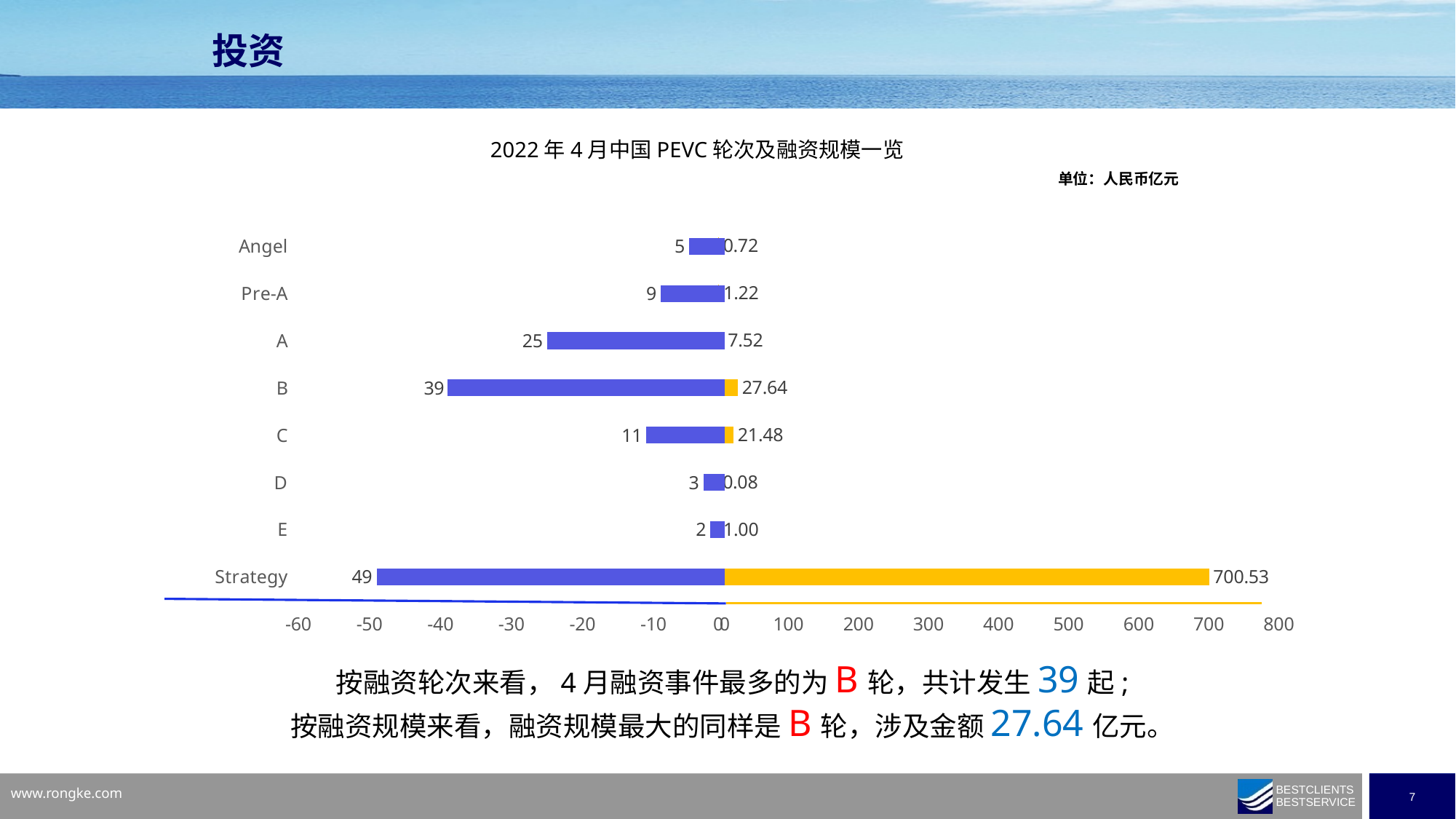
What is the difference in the number of financing events between the Strategy round and the B round? 10 Which round has the fewest financing events? E Which round has the smallest financing amount? D What is the title of the chart? 2022 年 4 月中国 PEVC 轮次及融资规模一览 Which has more financing events, the A round or the C round? A What is the financing amount for the C round? 21.48 How many financing rounds (categories) are listed on the chart? 8 Which round has the largest financing amount? Strategy What is the number of financing events for the B round? 39 What kind of chart is shown on the slide? bar chart What is the number of financing events for the Pre-A round? 9 What is the financing amount for the Strategy round? 700.53